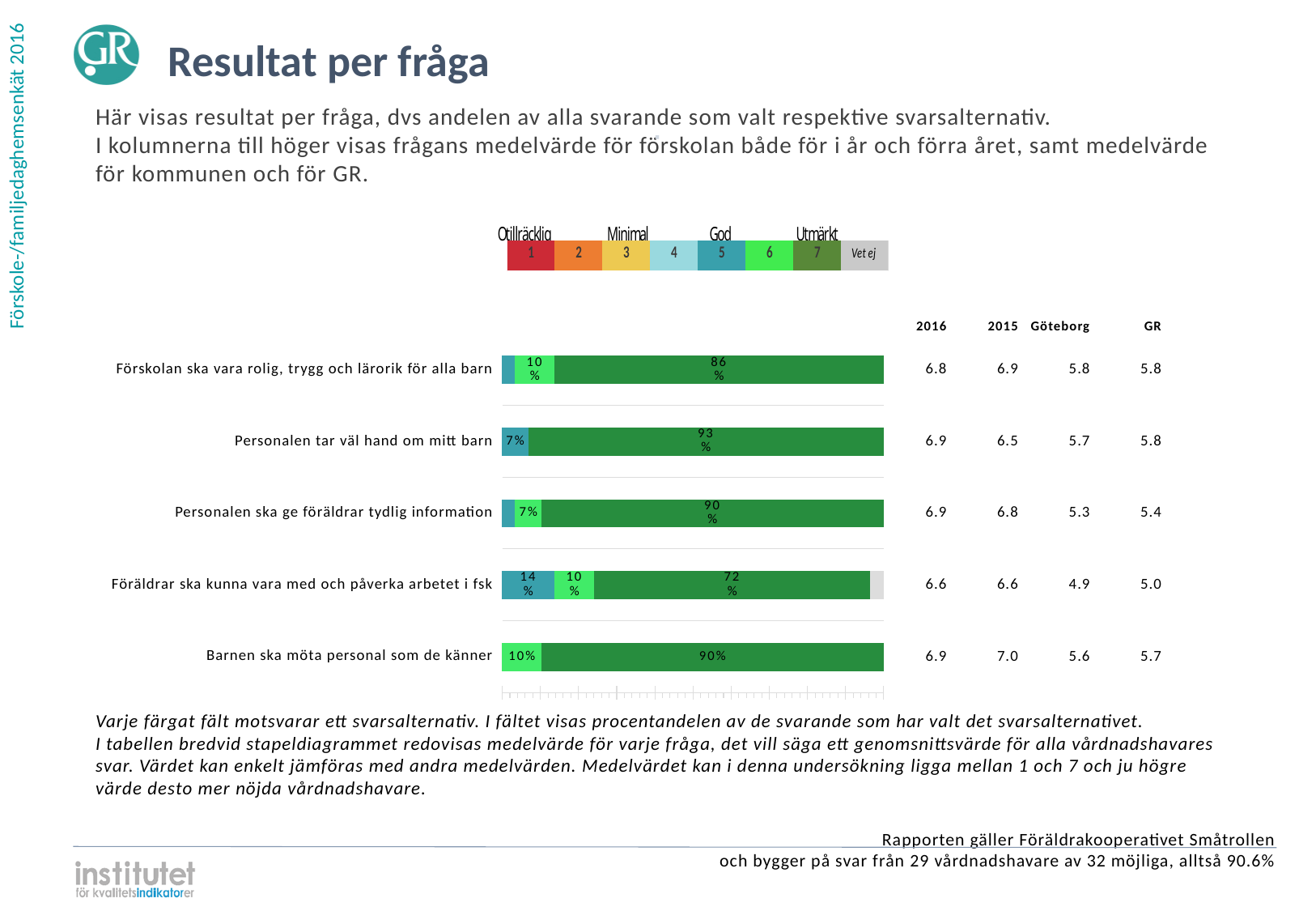
What percentage of respondents chose 5 for "Föräldrar ska kunna vara med och påverka arbetet i fsk"? 14% Which question has the highest share of respondents choosing 7 (Utmärkt)? Personalen tar väl hand om mitt barn What percentage of respondents chose 7 (Utmärkt) for "Personalen tar väl hand om mitt barn"? 93% What type of chart is used to show the results per question? Stacked bar chart What percentage of respondents chose 7 (Utmärkt) for "Föräldrar ska kunna vara med och påverka arbetet i fsk"? 72% How many response options does the legend above the chart list, including "Vet ej"? 8 How many questions (bars) are shown in the chart? 5 What percentage of respondents chose 6 for "Förskolan ska vara rolig, trygg och lärorik för alla barn"? 10% Which question has the lowest share of respondents choosing 7 (Utmärkt)? Föräldrar ska kunna vara med och påverka arbetet i fsk What is the difference between the share choosing 7 for "Personalen tar väl hand om mitt barn" and for "Föräldrar ska kunna vara med och påverka arbetet i fsk"? 21 percentage points Which has a larger share of respondents choosing 7: "Barnen ska möta personal som de känner" or "Förskolan ska vara rolig, trygg och lärorik för alla barn"? Barnen ska möta personal som de känner What is the 2016 mean value (medelvärde) for "Föräldrar ska kunna vara med och påverka arbetet i fsk"? 6.6